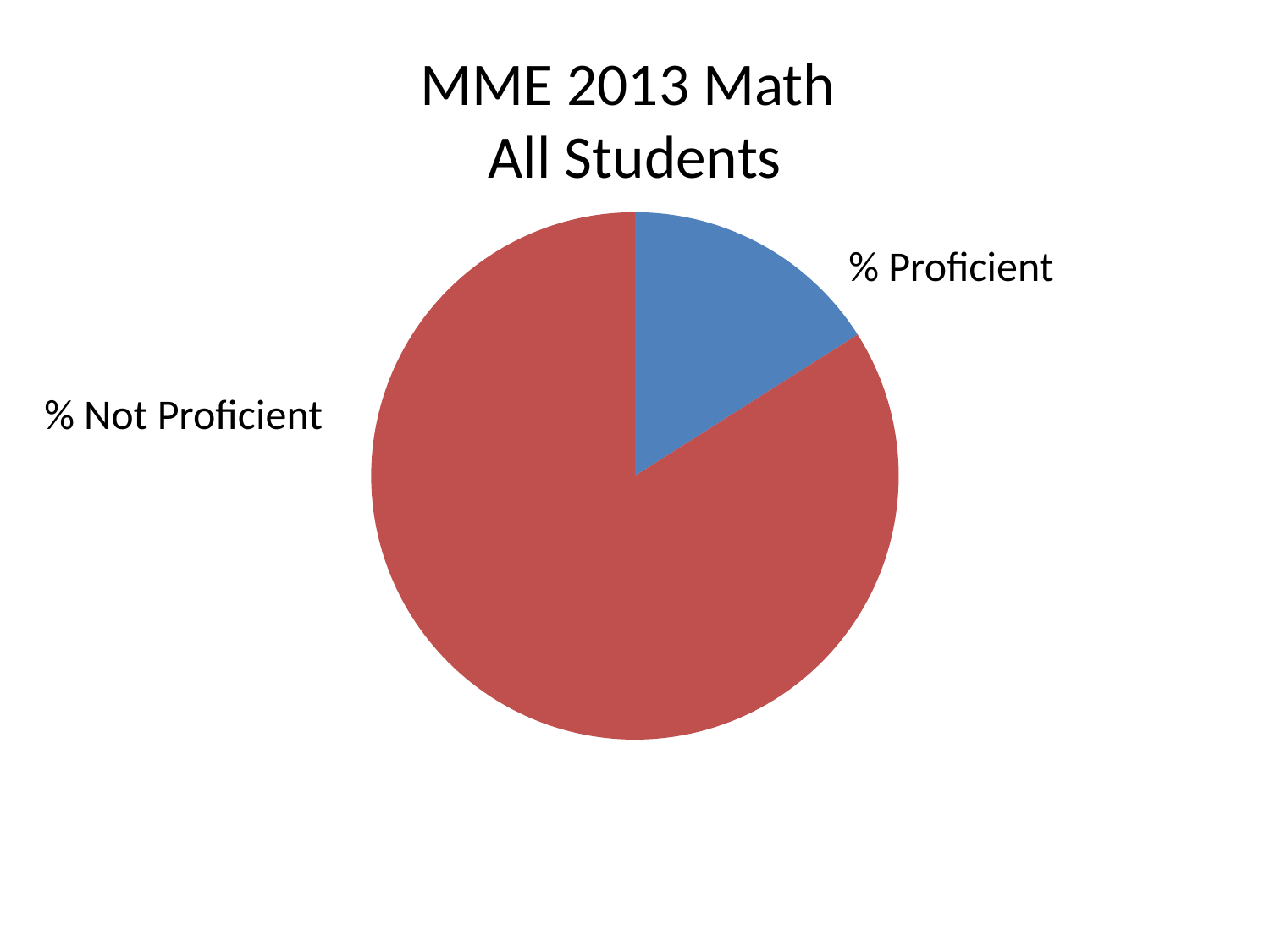
Which is larger, the % Proficient slice or the % Not Proficient slice? % Not Proficient How many slices does the pie chart have? 2 What colour is the % Proficient slice? blue Does the % Not Proficient slice take up more or less than half of the pie? more Which slice is the largest in the pie chart? % Not Proficient What is the title of the chart? MME 2013 Math All Students Which slice is the smallest in the pie chart? % Proficient What kind of chart is shown on the slide? pie chart